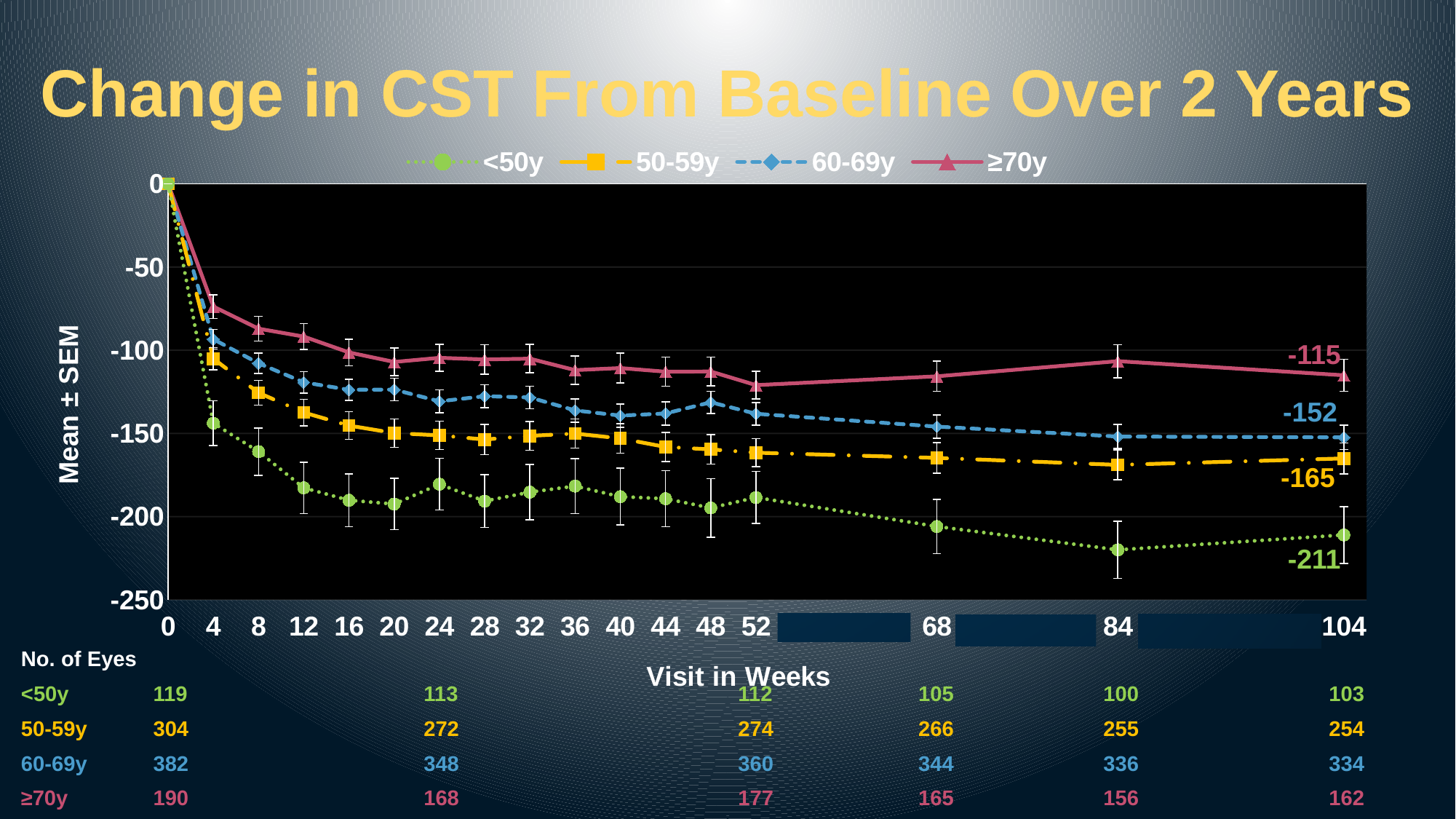
What is the difference between the week 104 values of the ≥70y group and the <50y group? 96 What is the change in CST from baseline for the 50-59y group at week 104? -165 What kind of chart is shown on the slide? line chart Is the value for the <50y group at week 84 greater or less than -200? less What is the change in CST from baseline for the <50y group at week 104? -211 Which age group has the lowest (most negative) value at week 104? <50y How many series does the legend list? 4 What is the change in CST from baseline for the ≥70y group at week 104? -115 What is the title of the chart? Change in CST From Baseline Over 2 Years What is the change in CST from baseline for the 60-69y group at week 104? -152 Do the values for the <50y group rise or fall from week 0 to week 104? fall Which age group has the highest (least negative) value at week 104? ≥70y